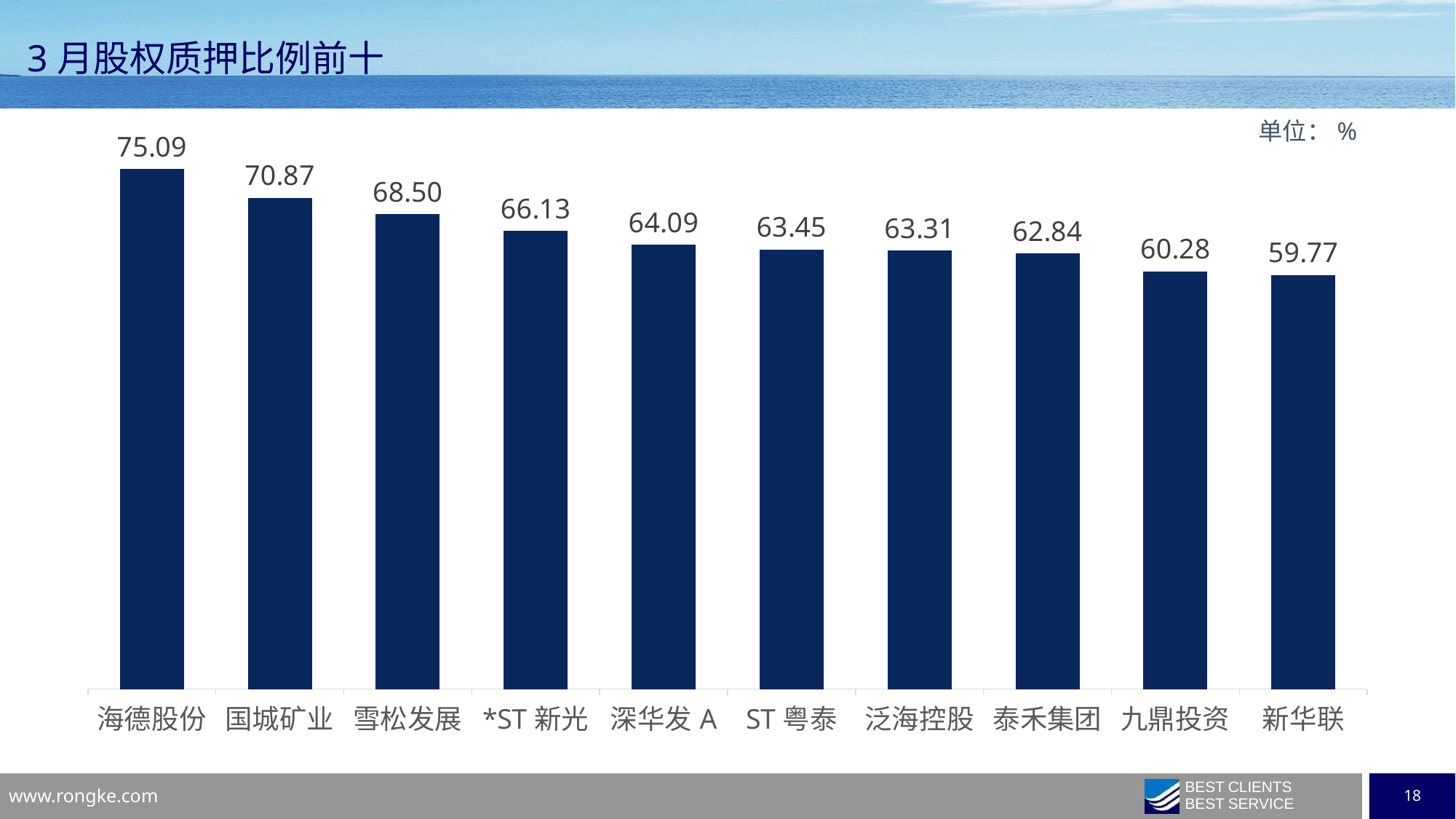
What is the value for 海德股份? 75.09 What is the title of the chart? 3 月股权质押比例前十 What is the difference between the values for 雪松发展 and 九鼎投资? 8.22 What kind of chart is shown on the slide? Bar chart Which category has the lowest value? 新华联 Do the values rise or fall from left to right along the x axis? Fall What is the difference between the values for 海德股份 and 国城矿业? 4.22 Which is larger, the value for *ST 新光 or the value for 深华发 A? *ST 新光 How many categories are shown in the chart? 10 What is the value for 新华联? 59.77 What is the value for 泛海控股? 63.31 Which category has the highest value? 海德股份